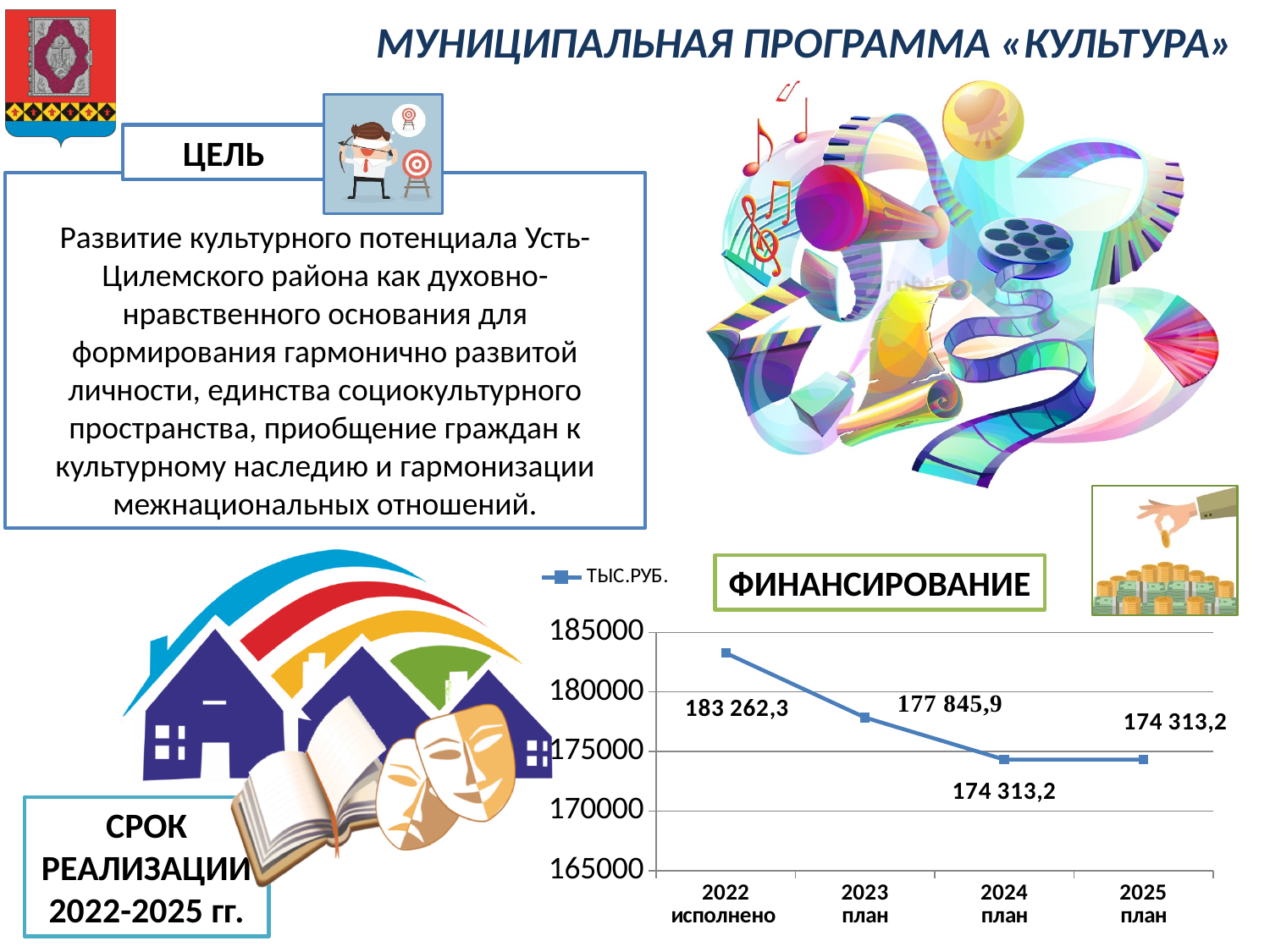
What is the value for 2025 план on the financing chart? 174 313,2 Is the value for 2022 исполнено greater or less than 180000? greater What is the value for 2024 план on the financing chart? 174 313,2 What is the value for 2022 исполнено on the financing chart? 183 262,3 What kind of chart is used to show the financing data? line chart What is the value for 2023 план on the financing chart? 177 845,9 What is the difference between the values for 2023 план and 2024 план? 3 532,7 Do the values on the financing chart rise or fall from 2022 to 2024? fall Which is larger, the value for 2022 исполнено or the value for 2024 план? 2022 исполнено What is the difference between the values for 2022 исполнено and 2023 план? 5 416,4 Which category has the highest value on the financing chart? 2022 исполнено How many data points are plotted on the financing chart? 4